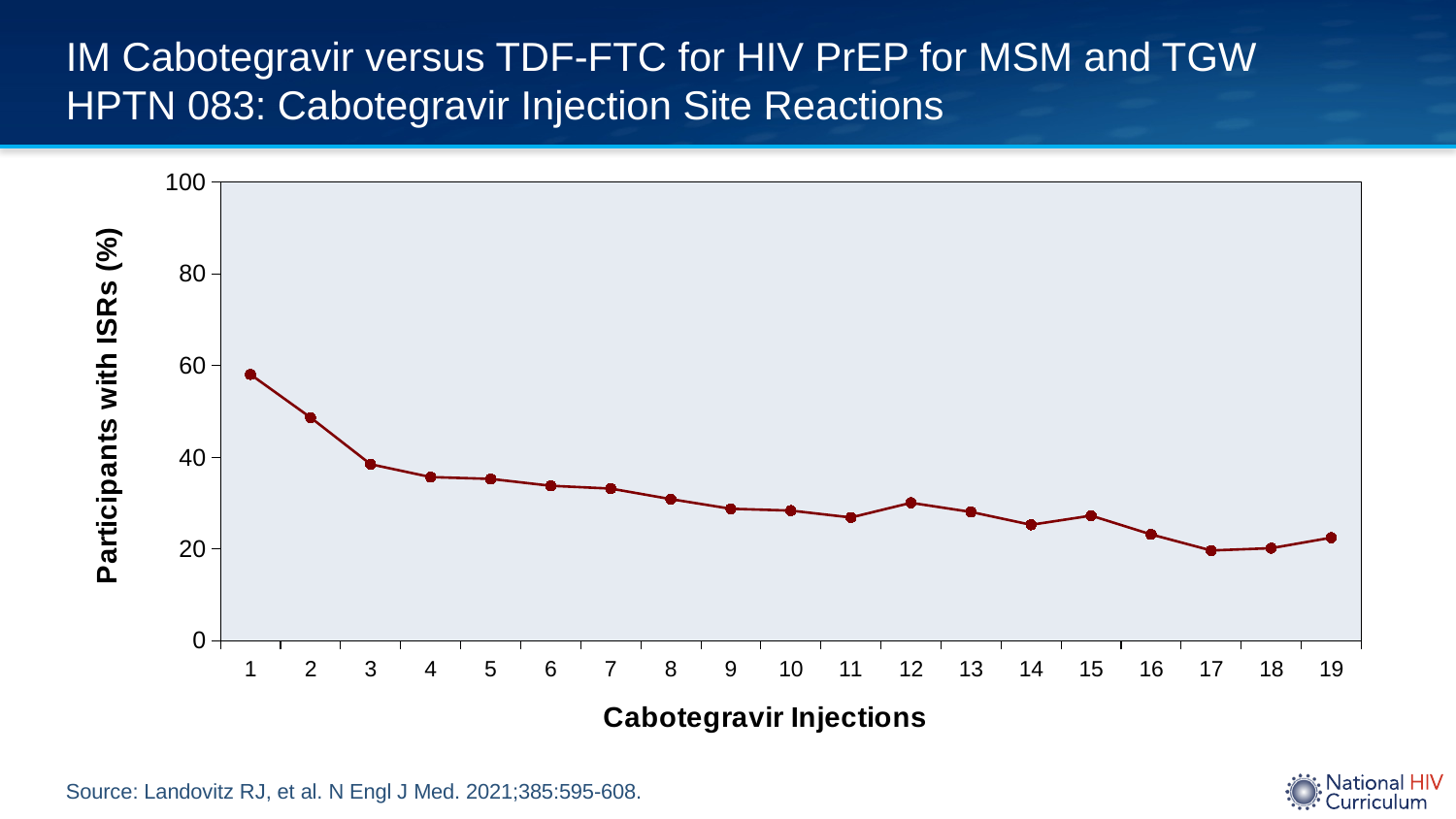
Which has a higher percentage of participants with ISRs, injection 1 or injection 19? Injection 1 What kind of chart is shown on the slide? Line chart How many cabotegravir injections (data points) are plotted on the x axis? 19 What is the label of the y axis? Participants with ISRs (%) Overall, do the values rise or fall as the injection number increases? Fall Is the value for injection 1 greater or less than 40? greater At which cabotegravir injection number is the percentage of participants with ISRs highest? 1 Is the value for injection 2 greater or less than 40? greater Which has a higher percentage of participants with ISRs, injection 2 or injection 3? Injection 2 Is the value for injection 8 greater or less than 40? less